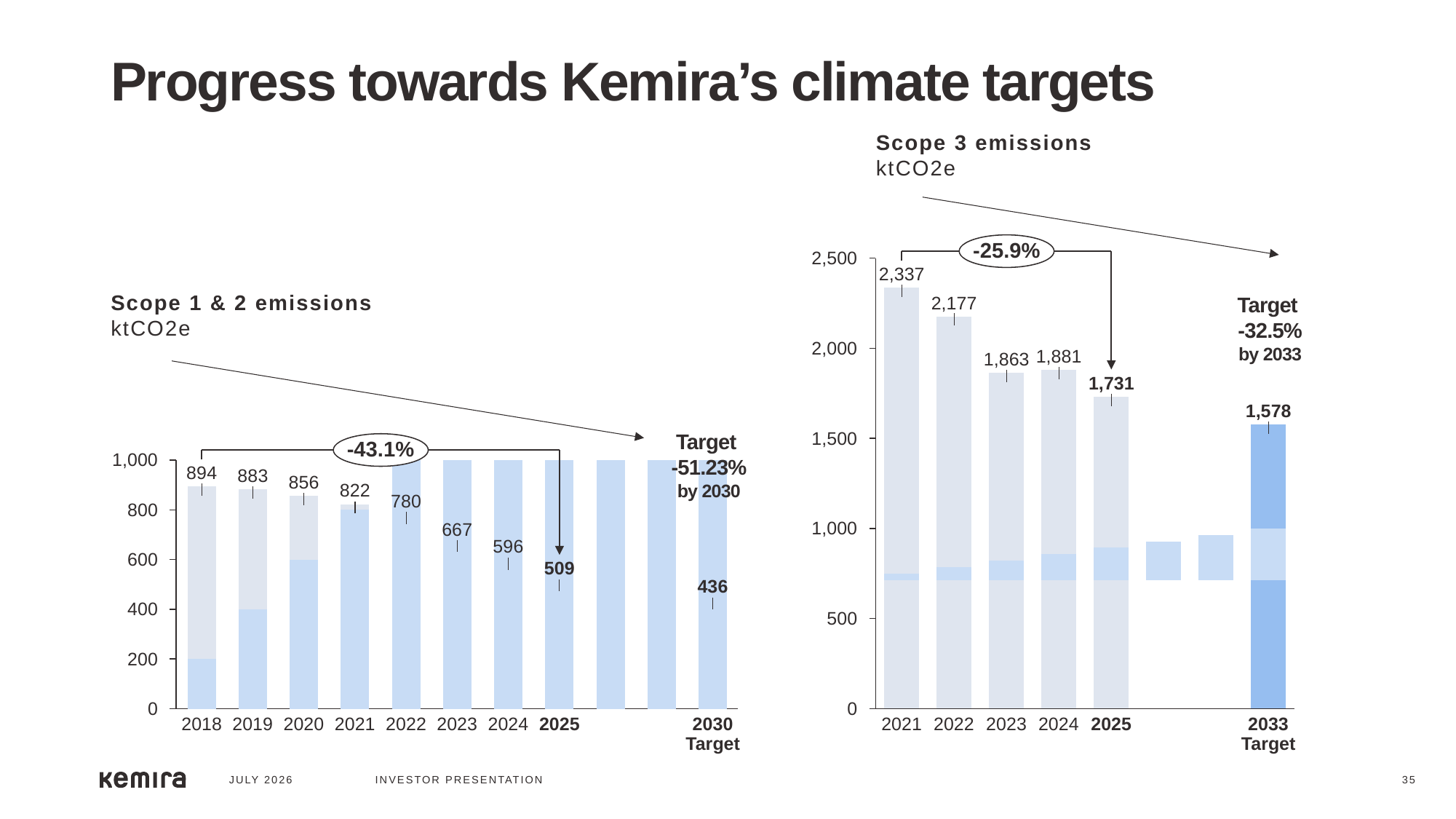
In the Scope 1 & 2 emissions chart, what is the value for 2025? 509 In the Scope 1 & 2 emissions chart, what percentage change is shown between 2018 and 2025? -43.1% In the Scope 3 emissions chart, what is the value for 2021? 2,337 In the Scope 1 & 2 emissions chart, what is the value shown for the 2030 Target? 436 In the Scope 3 emissions chart, what is the value for 2025? 1,731 In the Scope 3 emissions chart, what is the difference between the 2021 value and the 2022 value? 160 In the Scope 1 & 2 emissions chart, what is the difference between the 2018 value and the 2025 value? 385 In the Scope 3 emissions chart, what is the value shown for the 2033 Target? 1,578 What kind of chart is the Scope 3 emissions chart? Bar chart In the Scope 1 & 2 emissions chart, which year has the highest labelled value? 2018 In the Scope 1 & 2 emissions chart, what is the value for 2018? 894 In the Scope 3 emissions chart, which is larger, the value for 2023 or the value for 2024? 2024